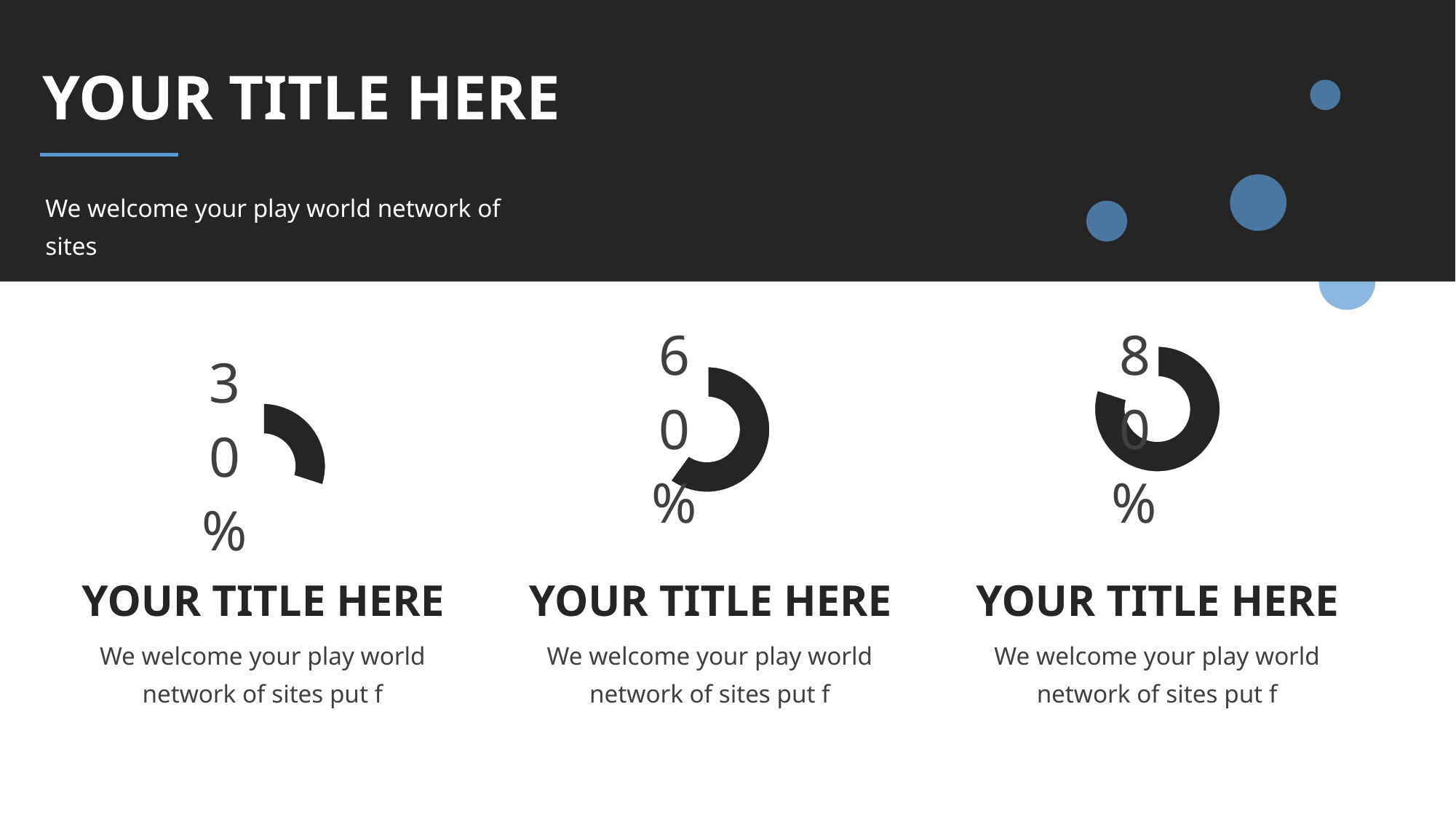
How many doughnut charts are on the slide? 3 Which is larger, the percentage on the middle chart or the percentage on the left chart? The middle chart (60%) What percentage is shown on the right chart? 80% What is the difference between the percentage on the middle chart and the percentage on the left chart? 30% What percentage is shown on the left chart? 30% Which of the three charts shows the highest percentage? The right chart (80%) Do the percentages shown on the charts increase or decrease from left to right across the slide? Increase Which of the three charts shows the lowest percentage? The left chart (30%) What percentage is shown on the middle chart? 60% What kind of chart is used for the three percentage figures on the slide? Doughnut chart What is the difference between the percentage on the right chart and the percentage on the left chart? 50% What colour is the filled segment of each doughnut chart? Black